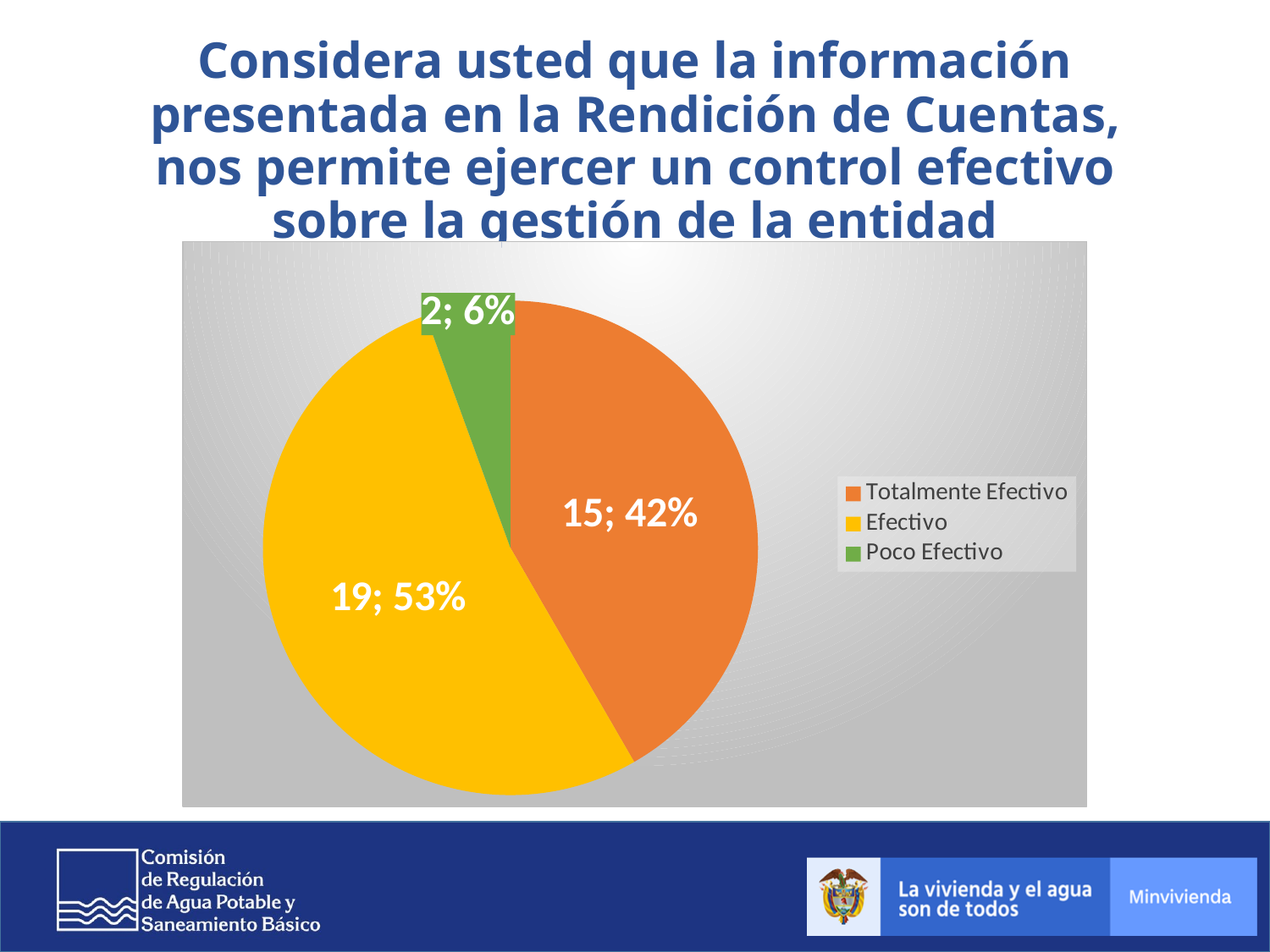
How many entries does the legend list? 3 What percentage of the pie does "Poco Efectivo" represent? 6% What is the difference in count between "Efectivo" and "Totalmente Efectivo"? 4 Which category has the largest slice? Efectivo What percentage of the pie does "Efectivo" represent? 53% How many respondents answered "Poco Efectivo"? 2 How many slices does the pie chart have? 3 Which category has the smallest slice? Poco Efectivo What kind of chart is shown on the slide? Pie chart Which colour represents "Totalmente Efectivo" in the pie chart? Orange How many respondents answered "Totalmente Efectivo"? 15 How many respondents answered "Efectivo"? 19